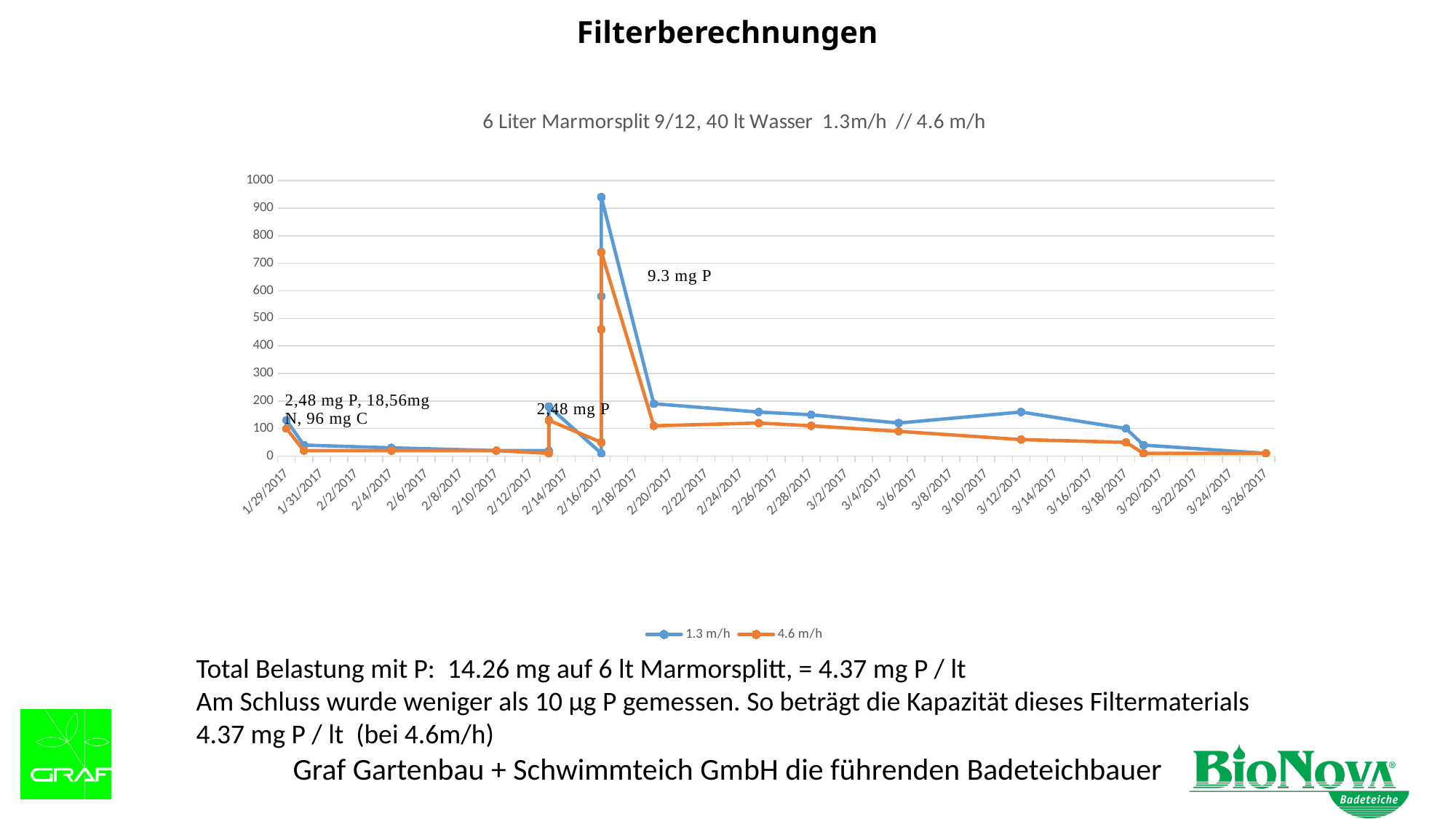
Do the values of the 4.6 m/h series rise or fall overall from 2/20/2017 to 3/26/2017? fall Is the peak value of the 4.6 m/h series greater or less than 800? less What kind of chart is shown on the slide? line chart Is the value for 4.6 m/h on 2/20/2017 greater or less than 150? less Is the value for 1.3 m/h on 3/12/2017 greater or less than 100? greater What colour is the 4.6 m/h series drawn in? orange What is the title of the chart? 6 Liter Marmorsplit 9/12, 40 lt Wasser 1.3m/h // 4.6 m/h How many series does the chart's legend list? 2 On which date does the 1.3 m/h series reach its peak? 2/16/2017 On 3/12/2017, which series has the larger value, 1.3 m/h or 4.6 m/h? 1.3 m/h Which series reaches the highest value on the chart? 1.3 m/h